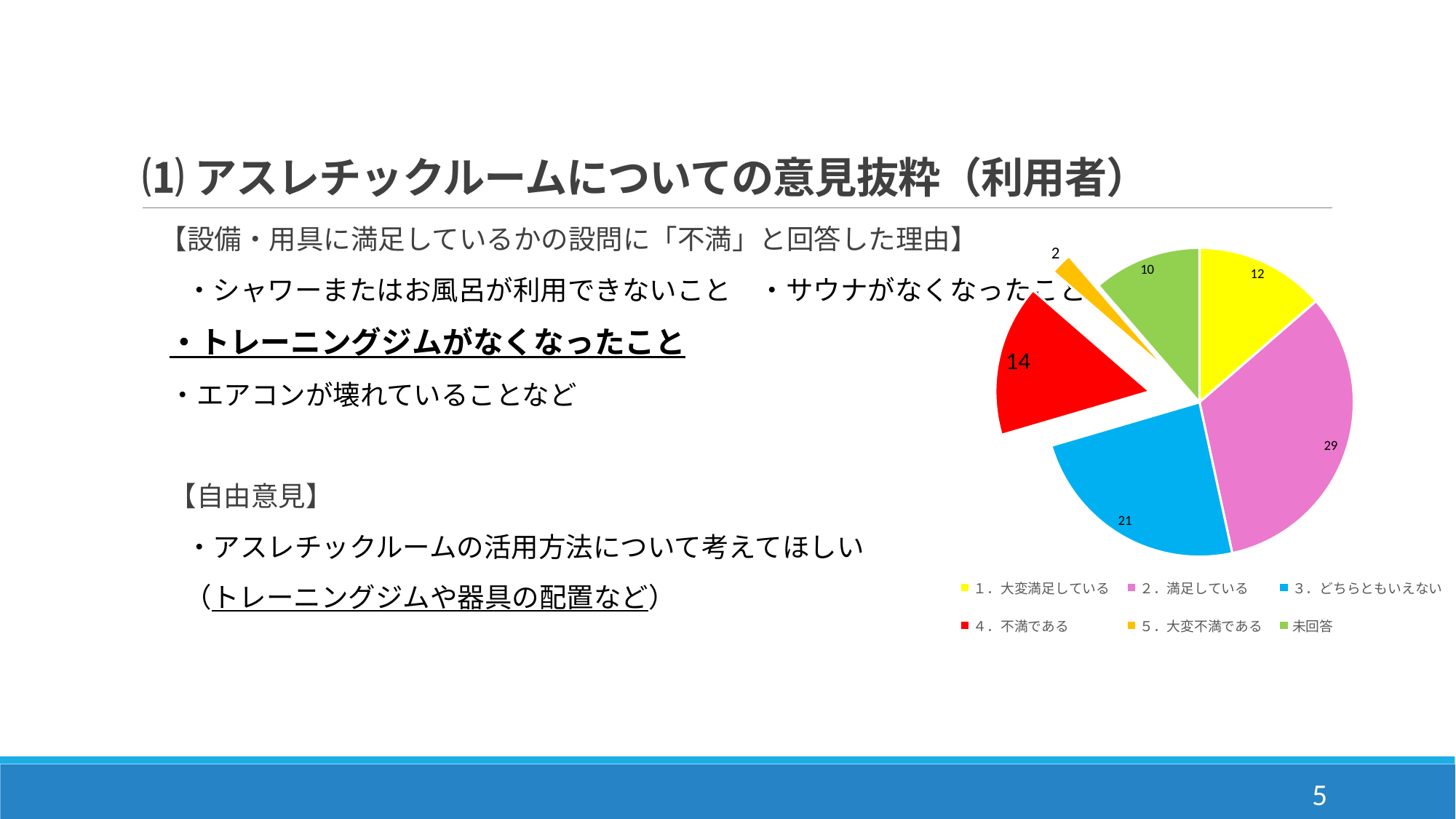
What colour is the slice for 4．不満である in the pie chart? red Which is larger, the value for 1．大変満足している or the value for 4．不満である? 4．不満である What is the value for 4．不満である in the pie chart? 14 What is the value for 3．どちらともいえない in the pie chart? 21 What is the difference between the values for 2．満足している and 3．どちらともいえない? 8 What is the value for 2．満足している in the pie chart? 29 Which category has the smallest slice in the pie chart? 5．大変不満である How many entries does the legend of the pie chart list? 6 What kind of chart is shown on the slide? pie chart Which category has the largest slice in the pie chart? 2．満足している What is the value for 未回答 in the pie chart? 10 How many slices does the pie chart have? 6